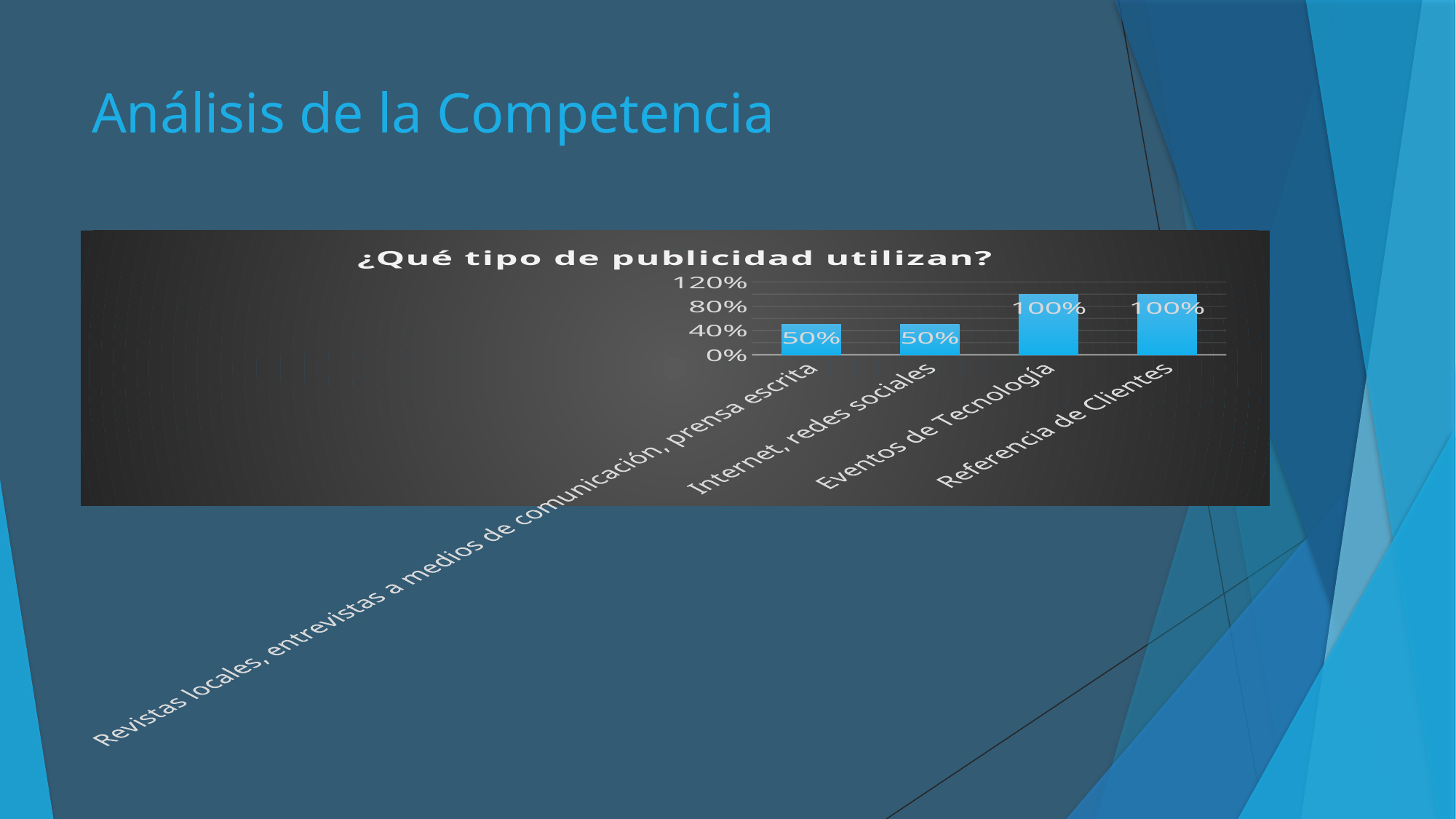
What is the value for Eventos de Tecnología? 100% How many categories are shown on the x axis? 4 What is the difference between the values for Eventos de Tecnología and Internet, redes sociales? 50% What is the value for Revistas locales, entrevistas a medios de comunicación, prensa escrita? 50% What is the value for Referencia de Clientes? 100% What is the highest value shown on the y axis? 120% What is the title of the chart? ¿Qué tipo de publicidad utilizan? Is the value for Eventos de Tecnología greater or less than 80%? greater What kind of chart is shown on the slide? bar chart Is the value for Internet, redes sociales greater or less than 80%? less What is the value for Internet, redes sociales? 50% Which is larger, the value for Referencia de Clientes or the value for Internet, redes sociales? Referencia de Clientes